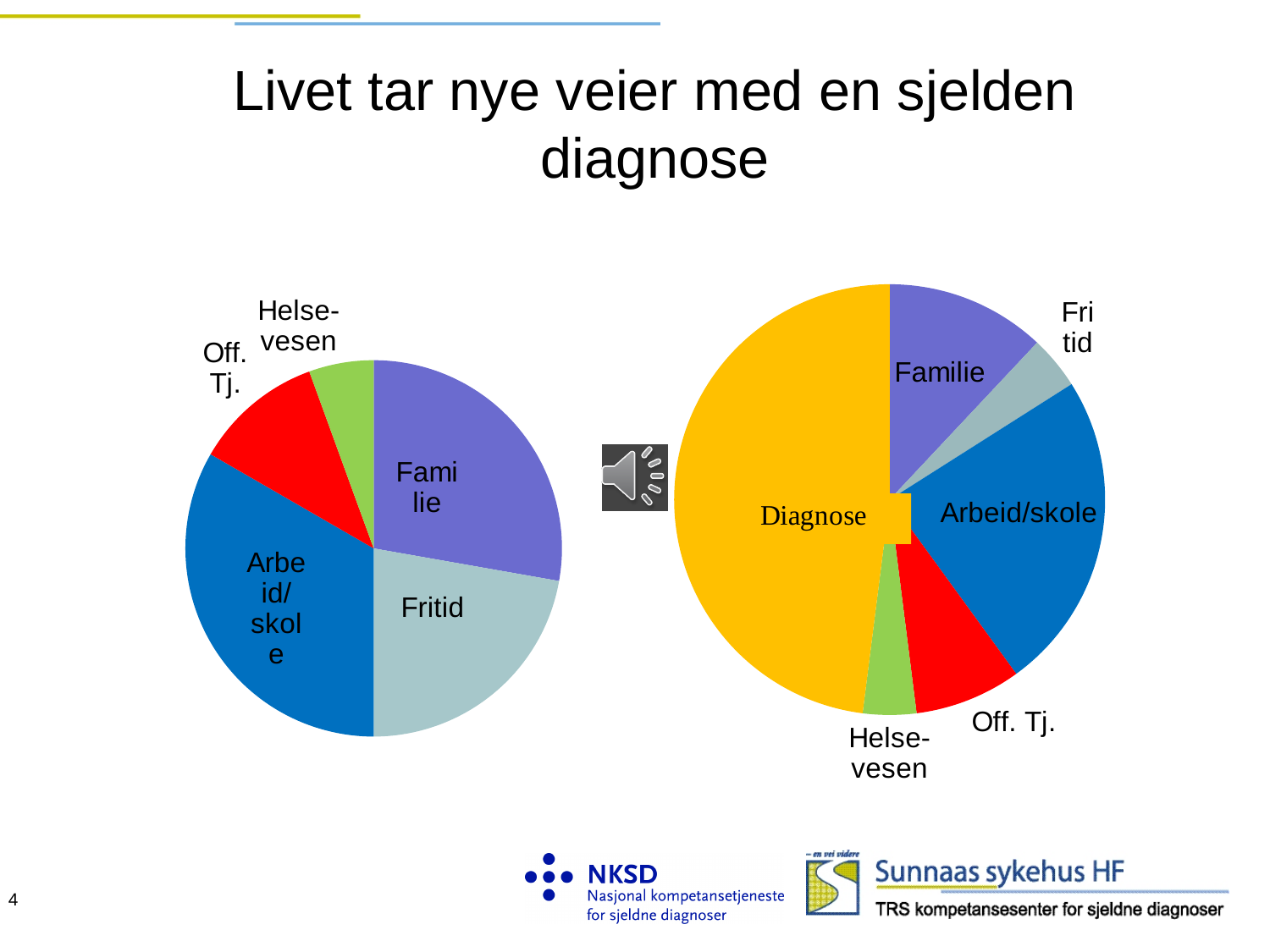
In the right pie chart, which is larger: Diagnose or Arbeid/skole? Diagnose In the right pie chart, which is larger: Familie or Helsevesen? Familie What kind of chart is the left chart on the slide? pie chart What kind of chart is the right chart on the slide? pie chart In the right pie chart, how many slices are there? 6 Which category appears in the right pie chart but not in the left pie chart? Diagnose In the left pie chart, which category has the smallest slice? Helsevesen In the right pie chart, what colour is the Diagnose slice? yellow In the left pie chart, which category has the largest slice? Arbeid/skole In the left pie chart, which is larger: Arbeid/skole or Fritid? Arbeid/skole In the left pie chart, how many slices are there? 5 In the right pie chart, which category has the largest slice? Diagnose